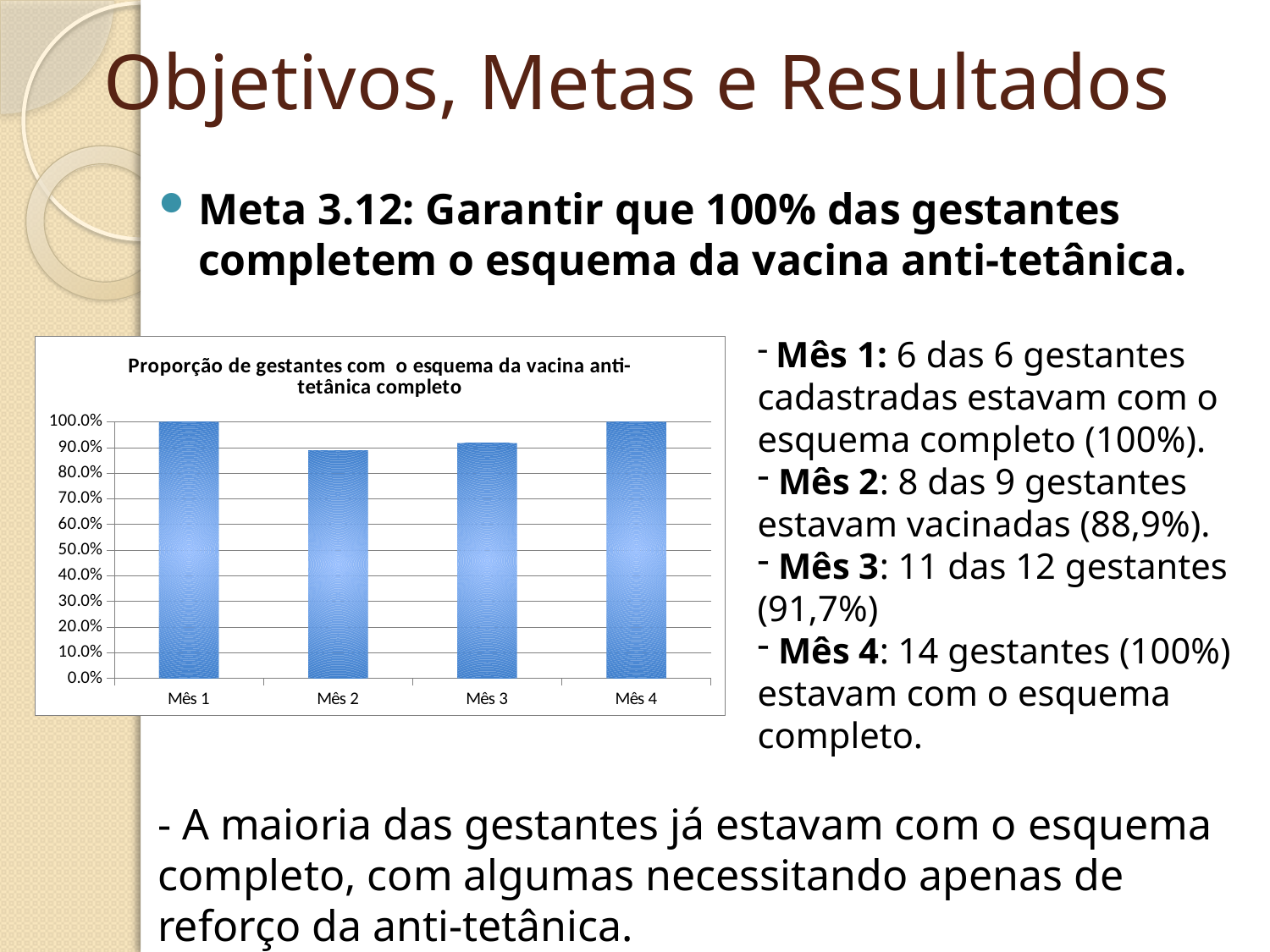
Is the value for Mês 2 greater or less than 80.0%? greater How many months are shown on the x axis of the chart? 4 What is the title of the chart? Proporção de gestantes com o esquema da vacina anti-tetânica completo What kind of chart is shown on the slide? Bar chart Which is larger, the value for Mês 2 or the value for Mês 3? Mês 3 Which month has the lowest proportion in the chart? Mês 2 Which is larger, the value for Mês 1 or the value for Mês 2? Mês 1 What is the value for Mês 1 in the chart? 100.0% Is the value for Mês 2 greater or less than 90.0%? less Is the value for Mês 3 greater or less than 90.0%? greater What is the difference between the values for Mês 1 and Mês 4? 0.0% What is the value for Mês 4 in the chart? 100.0%